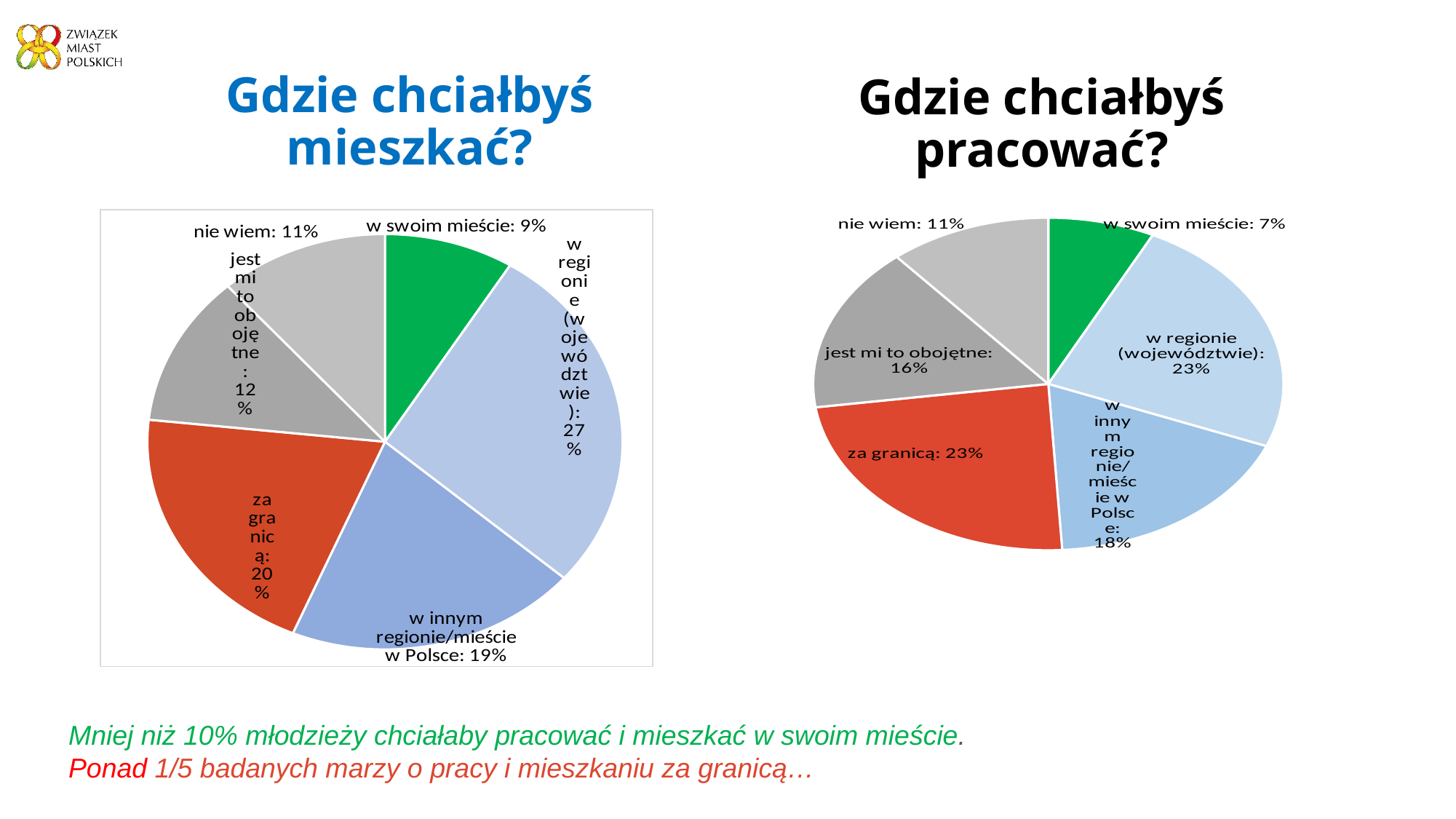
In the chart titled "Gdzie chciałbyś pracować?", what share is labelled for "w innym regionie/mieście w Polsce"? 18% In the chart titled "Gdzie chciałbyś mieszkać?", what is the difference between the shares for "w regionie (województwie)" and "w innym regionie/mieście w Polsce"? 8% What type of chart is the chart titled "Gdzie chciałbyś mieszkać?"? Pie chart In the chart titled "Gdzie chciałbyś pracować?", which category has the smallest slice? w swoim mieście In the chart titled "Gdzie chciałbyś pracować?", what is the difference between the shares for "za granicą" and "w swoim mieście"? 16% In the chart titled "Gdzie chciałbyś pracować?", what share is labelled for "jest mi to obojętne"? 16% In the chart titled "Gdzie chciałbyś mieszkać?", what share is labelled for "za granicą"? 20% In the chart titled "Gdzie chciałbyś mieszkać?", which category has the largest slice? w regionie (województwie) In the chart titled "Gdzie chciałbyś mieszkać?", what share is labelled for "w swoim mieście"? 9% In the chart titled "Gdzie chciałbyś mieszkać?", which category has the smallest slice? w swoim mieście In the chart titled "Gdzie chciałbyś pracować?", which is larger: "nie wiem" or "jest mi to obojętne"? jest mi to obojętne How many slices does the chart titled "Gdzie chciałbyś pracować?" have? 6